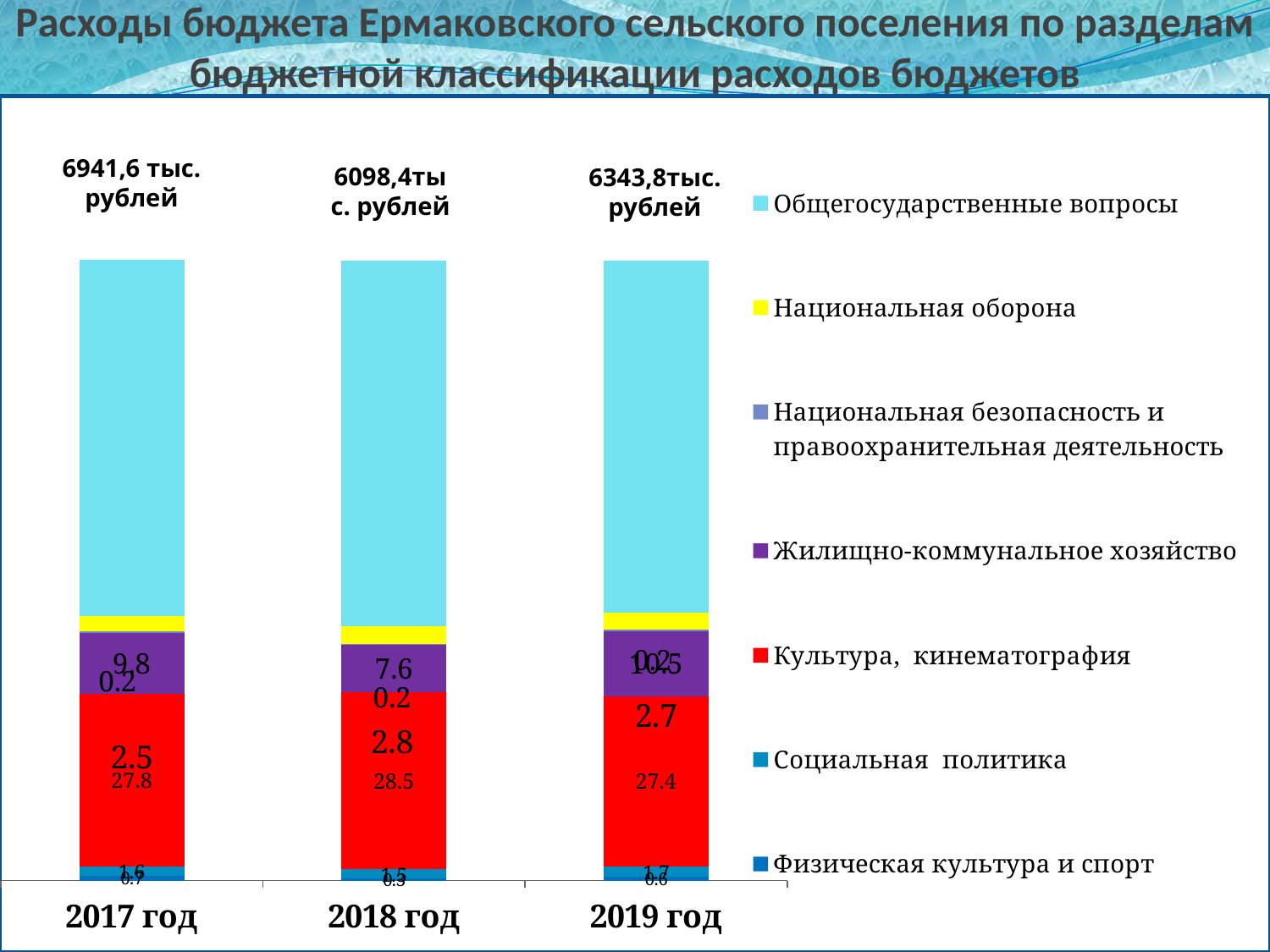
Which series forms the largest segment of every bar in the chart? Общегосударственные вопросы What is the value labelled on the Культура, кинематография segment for 2017 год? 27.8 Which year has the larger labelled value for Жилищно-коммунальное хозяйство, 2017 год or 2018 год? 2017 год How many years (categories) are shown on the x axis of the chart? 3 In which year is the labelled value for Культура, кинематография the highest? 2018 год What is the value labelled on the Жилищно-коммунальное хозяйство segment for 2017 год? 9.8 What kind of chart is shown on the slide? Stacked bar chart What total amount is written above the bar for 2017 год? 6941,6 тыс. рублей What is the difference between the Культура, кинематография values for 2018 год and 2017 год? 0.7 How many series does the chart legend list? 7 What is the value labelled on the Культура, кинематография segment for 2018 год? 28.5 What is the value labelled on the Культура, кинематография segment for 2019 год? 27.4